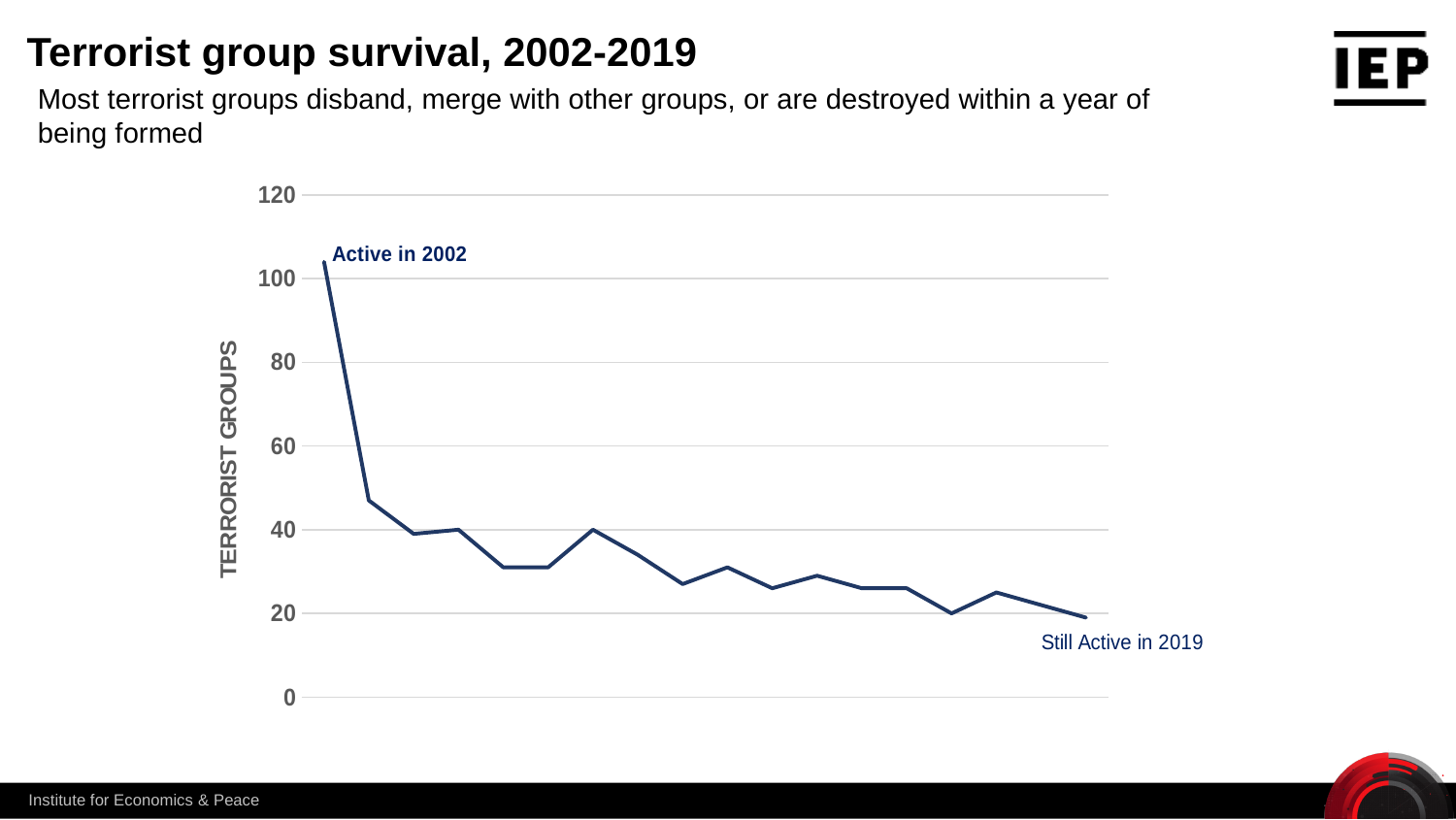
Is the value labelled 'Still Active in 2019' greater or less than 60? less Is the value labelled 'Active in 2002' greater or less than 80? greater Which point on the line is the highest? Active in 2002 What is the title of the y axis? TERRORIST GROUPS Do the values in the chart generally rise or fall from left to right? fall What is the title of the chart on the slide? Terrorist group survival, 2002-2019 Is the value labelled 'Still Active in 2019' greater or less than 40? less What kind of chart is shown on the slide? line chart Which is larger, the value labelled 'Active in 2002' or the value labelled 'Still Active in 2019'? Active in 2002 What is the highest value shown on the y axis? 120